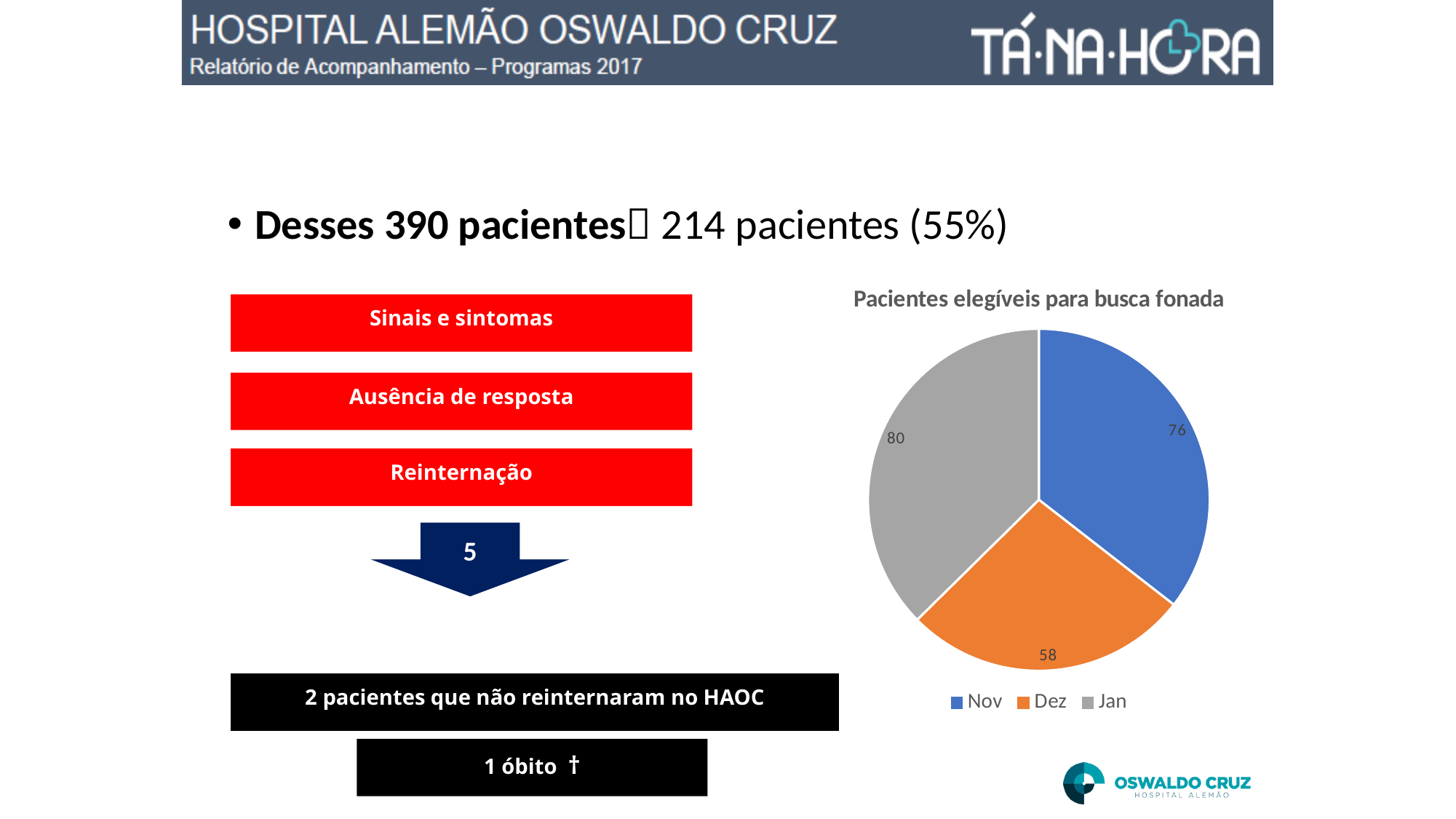
What is the value for Dez in the pie chart? 58 What is the value for Nov in the pie chart? 76 Which month has the largest slice in the pie chart? Jan What is the difference between the values for Nov and Dez? 18 How many slices does the pie chart have? 3 What is the difference between the values for Jan and Dez? 22 How many entries does the legend list? 3 What type of chart is shown on the slide? pie chart Which month has the smallest slice in the pie chart? Dez What is the value for Jan in the pie chart? 80 Which is larger, the value for Nov or the value for Dez? Nov What is the title of the chart? Pacientes elegíveis para busca fonada